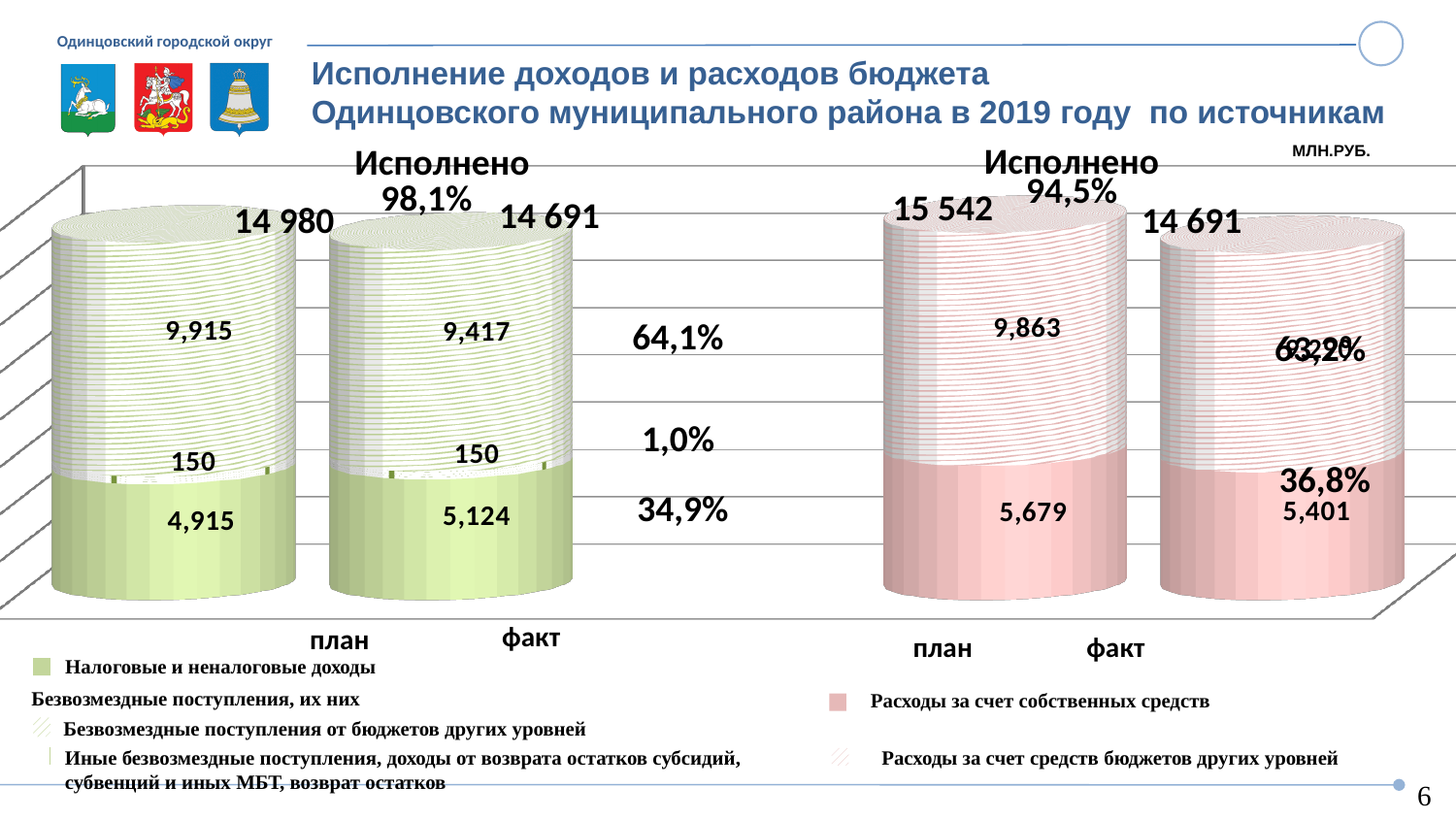
In the left chart (доходы), what is the difference between план and факт for Безвозмездные поступления от бюджетов других уровней? 498 In the right chart (расходы), what is the value of Расходы за счет средств бюджетов других уровней for план? 9,863 In the right chart (расходы), what is the value of Расходы за счет собственных средств for план? 5,679 In the left chart (доходы), what is the total of the факт bar? 14 691 In the right chart (расходы), what is the total of the план bar? 15 542 In the left chart (доходы), which is larger for Налоговые и неналоговые доходы: план or факт? факт In the right chart (расходы), what percentage is shown as Исполнено? 94,5% In the left chart (доходы), what is the value of Налоговые и неналоговые доходы for факт? 5,124 What type of chart is used on this slide? bar chart In the left chart (доходы), what is the total of the план bar? 14 980 In the left chart (доходы), what is the value of Налоговые и неналоговые доходы for план? 4,915 In the left chart (доходы), what percentage is shown as Исполнено? 98,1%